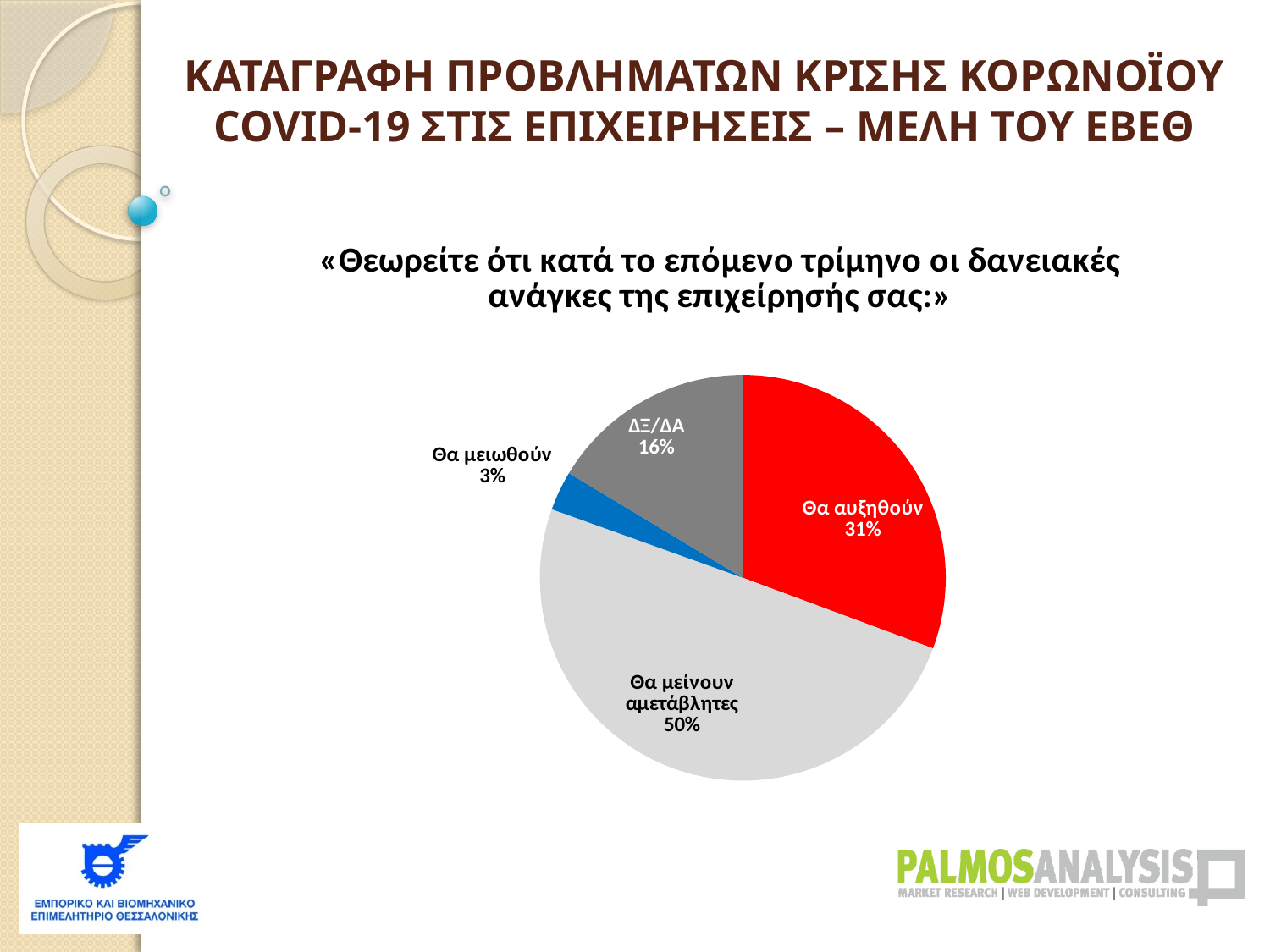
What share of respondents answered "Θα αυξηθούν"? 31% What share of respondents answered "Θα μείνουν αμετάβλητες"? 50% Which response has the largest share of the pie? Θα μείνουν αμετάβλητες What colour is the slice for "Θα αυξηθούν"? red What kind of chart is shown on the slide? pie chart How many slices does the pie chart have? 4 Which is larger, the share for "Θα αυξηθούν" or the share for "ΔΞ/ΔΑ"? Θα αυξηθούν What share of respondents answered "Θα μειωθούν"? 3% What colour is the slice for "Θα μειωθούν"? blue Which response has the smallest share of the pie? Θα μειωθούν What share of respondents answered "ΔΞ/ΔΑ"? 16% What is the difference in percentage points between "Θα μείνουν αμετάβλητες" and "Θα αυξηθούν"? 19 percentage points